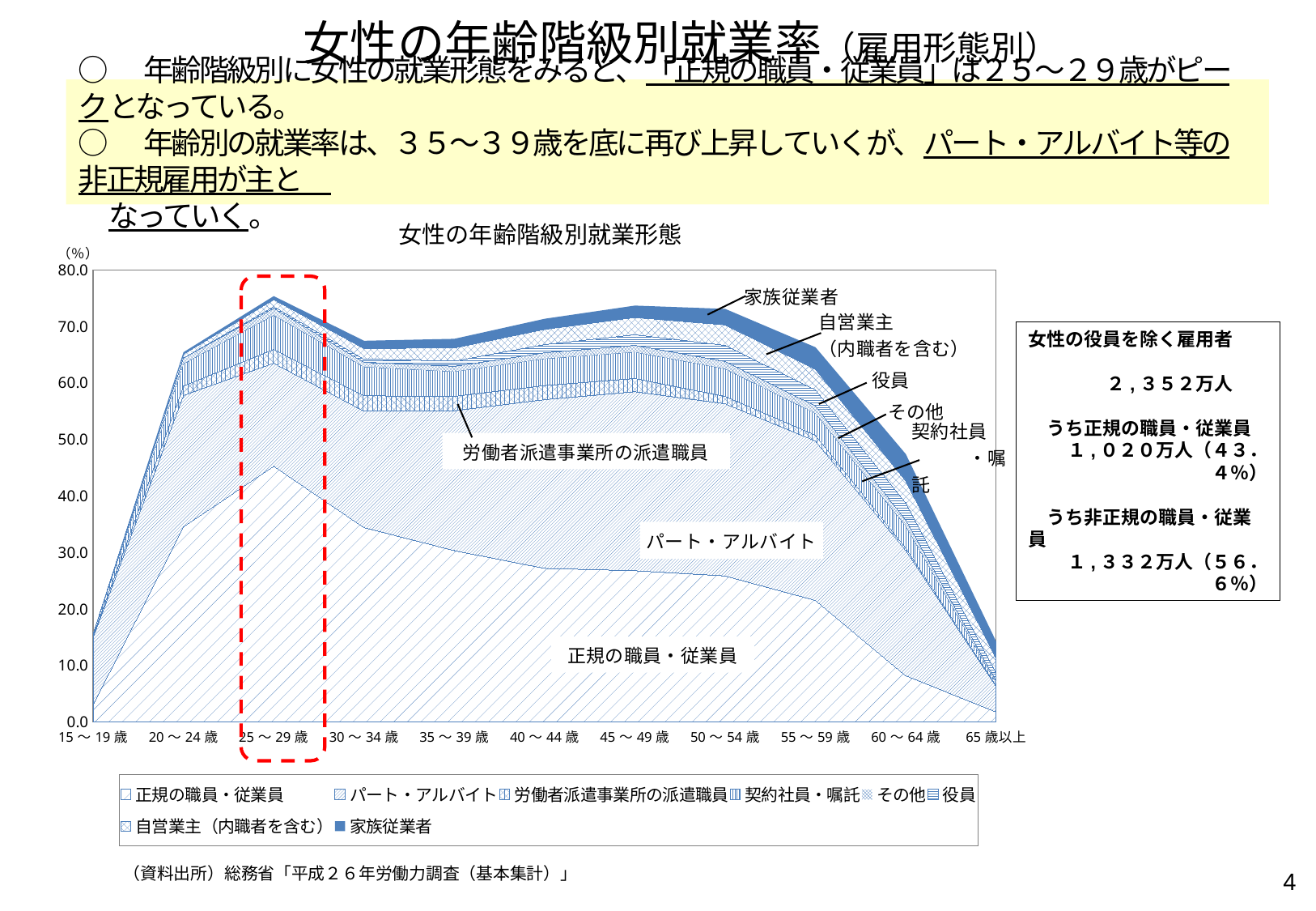
Does the total stacked value rise or fall from 25～29歳 to 35～39歳? fall Is the value for 正規の職員・従業員 at 45～49歳 greater or less than 30? less Is the total stacked value at 25～29歳 greater or less than 70? greater What kind of chart is shown on the slide? stacked area chart Which age group has the highest value for 正規の職員・従業員? 25～29歳 Is the value for 正規の職員・従業員 at 25～29歳 greater or less than 40? greater How many series does the chart's legend list? 8 What is the title of the chart? 女性の年齢階級別就業形態 What is the data source cited below the chart? 総務省「平成26年労働力調査（基本集計）」 How many age groups are shown on the x axis of the chart? 11 Which is larger, the value for 正規の職員・従業員 at 25～29歳 or at 45～49歳? 25～29歳